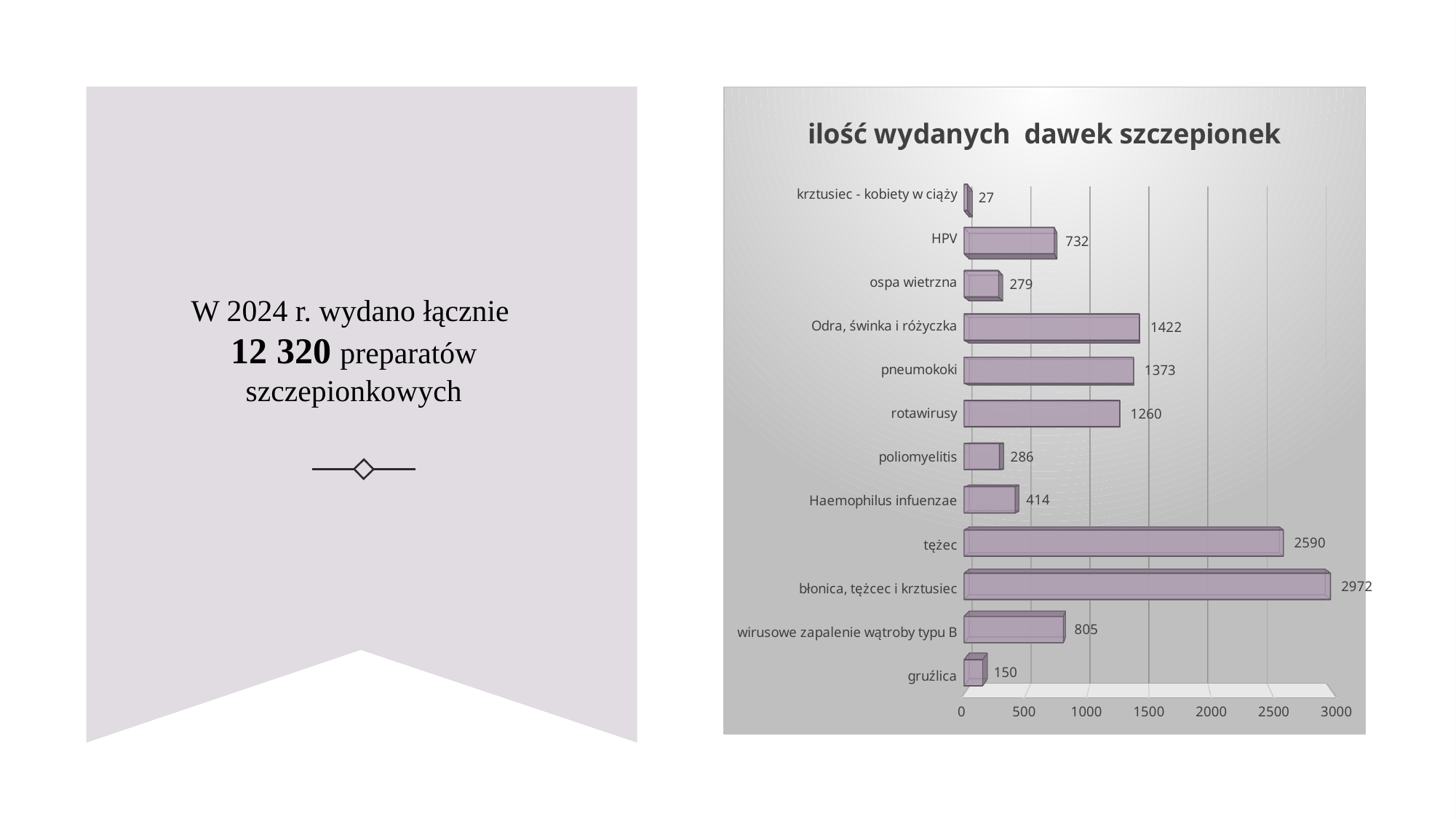
Which is larger, the value for Odra, świnka i różyczka or the value for rotawirusy? Odra, świnka i różyczka What is the value for HPV? 732 What is the difference between the values for tężec and Haemophilus infuenzae? 2176 What is the title of the chart? ilość wydanych dawek szczepionek What is the value for pneumokoki? 1373 What is the value for gruźlica? 150 Is the value for wirusowe zapalenie wątroby typu B greater or less than 1000? less Which category has the highest value? błonica, tężcec i krztusiec What is the difference between the values for poliomyelitis and ospa wietrzna? 7 What kind of chart is shown on the slide? bar chart How many categories are shown in the chart? 12 Which category has the lowest value? krztusiec - kobiety w ciąży